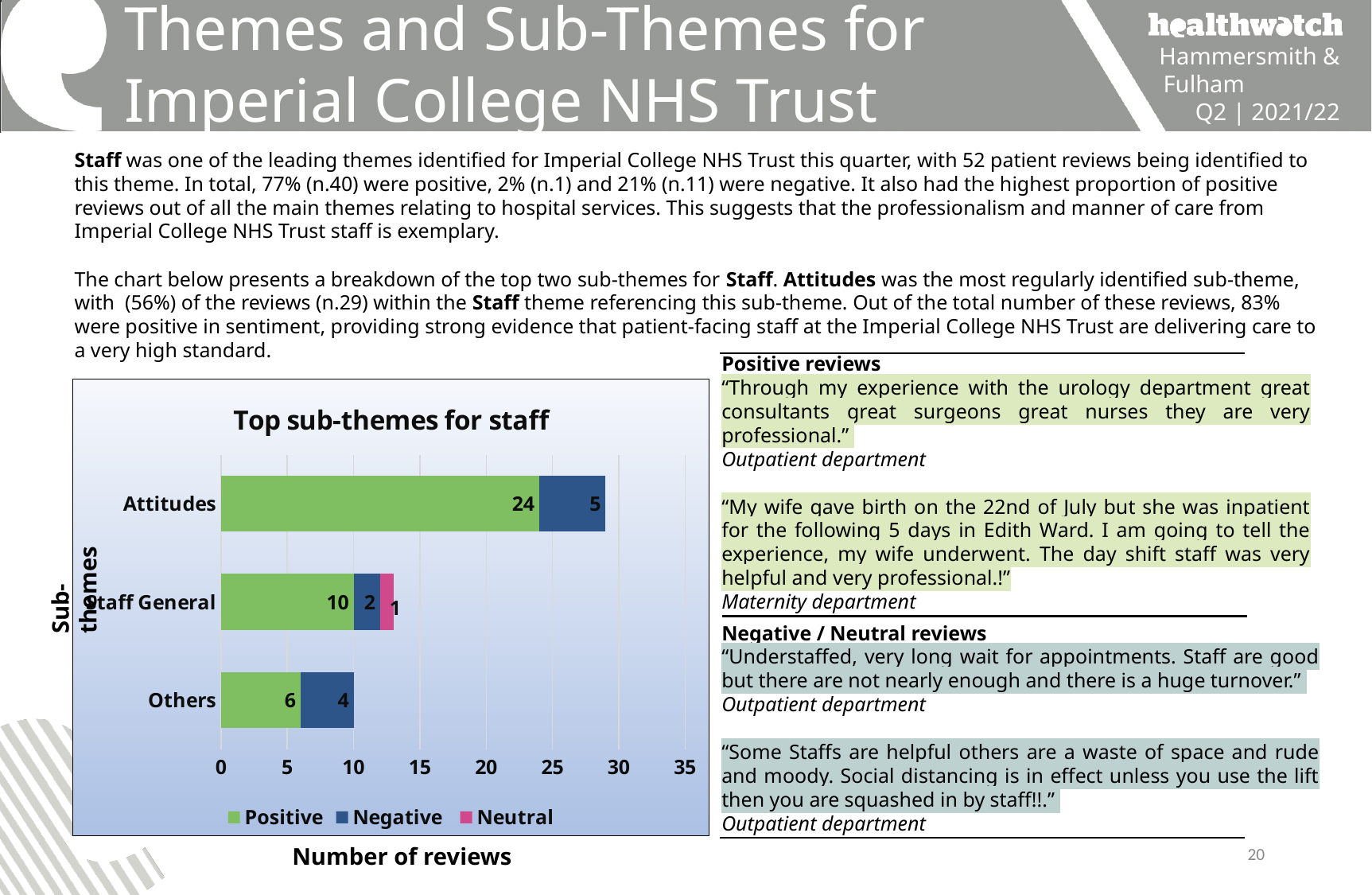
How many sub-theme categories are shown in the 'Top sub-themes for staff' chart? 3 What kind of chart is 'Top sub-themes for staff'? Stacked bar chart Is the Positive value for Others larger or smaller than the Negative value for Attitudes in the 'Top sub-themes for staff' chart? larger What is the Positive value for Attitudes in the 'Top sub-themes for staff' chart? 24 Which sub-theme has the highest Positive value in the 'Top sub-themes for staff' chart? Attitudes What is the Neutral value for Staff General in the 'Top sub-themes for staff' chart? 1 What is the total number of reviews for the Staff General bar in the 'Top sub-themes for staff' chart? 13 What is the total number of reviews for the Attitudes bar in the 'Top sub-themes for staff' chart? 29 What is the Negative value for Others in the 'Top sub-themes for staff' chart? 4 Which sub-theme has the lowest Negative value in the 'Top sub-themes for staff' chart? Staff General How many series does the legend of the 'Top sub-themes for staff' chart list? 3 What is the difference between the Positive values for Attitudes and Staff General in the 'Top sub-themes for staff' chart? 14